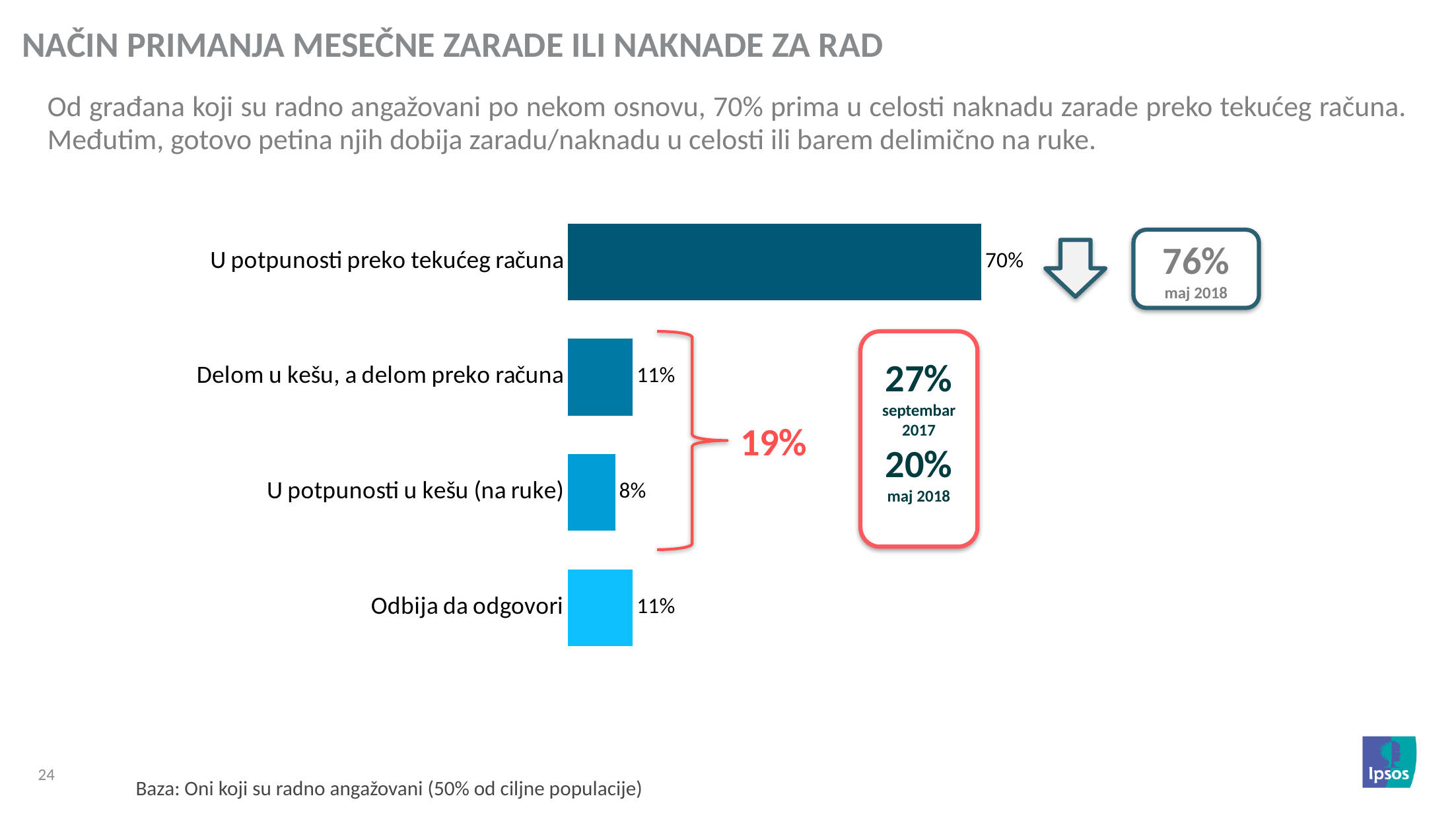
Which category has the lowest value? U potpunosti u kešu (na ruke) What is the difference between the values for "U potpunosti preko tekućeg računa" and "Delom u kešu, a delom preko računa"? 59% What is the difference between the values for "Delom u kešu, a delom preko računa" and "U potpunosti u kešu (na ruke)"? 3% What is the value for "U potpunosti preko tekućeg računa"? 70% What kind of chart is shown on the slide? Bar chart How many categories are shown in the chart? 4 What combined percentage is shown by the red bracket grouping the two cash-related categories? 19% What is the value for "Delom u kešu, a delom preko računa"? 11% What is the value for "U potpunosti u kešu (na ruke)"? 8% Which is larger, the value for "Odbija da odgovori" or the value for "U potpunosti u kešu (na ruke)"? Odbija da odgovori Which category has the highest value? U potpunosti preko tekućeg računa What is the value for "Odbija da odgovori"? 11%